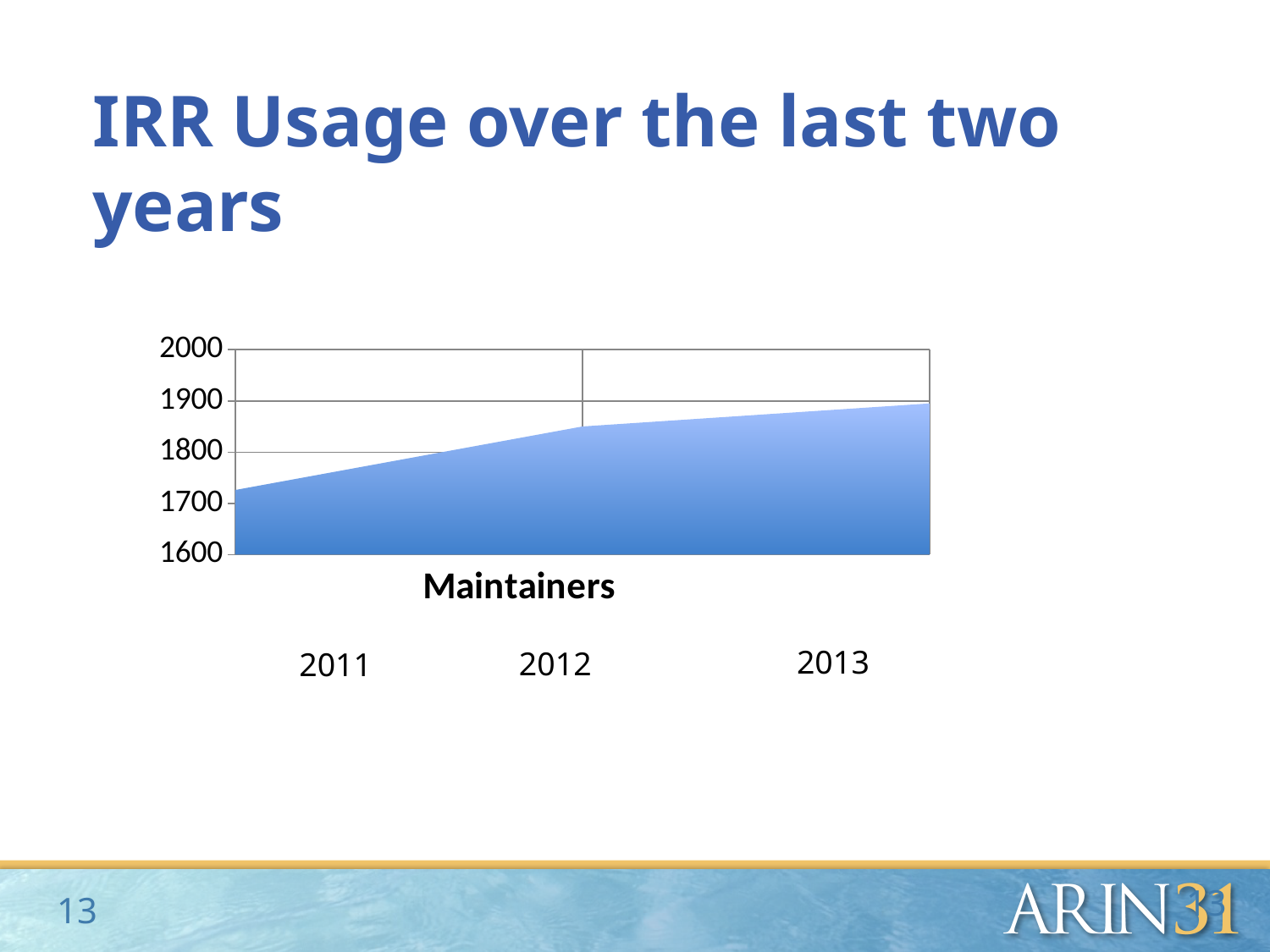
Is the Maintainers value for 2012 greater or less than 1800? greater How many series does the chart show? 1 Is the Maintainers value for 2012 greater or less than 1900? less What kind of chart is shown on the slide? area chart How many years are plotted on the x axis of the chart? 3 Which year has the highest Maintainers value? 2013 Do the Maintainers values rise or fall from 2011 to 2013? rise Which year has the lowest Maintainers value? 2011 Is the Maintainers value for 2011 greater or less than 1800? less What is the title of the slide containing the chart? IRR Usage over the last two years Which year has the larger Maintainers value, 2011 or 2012? 2012